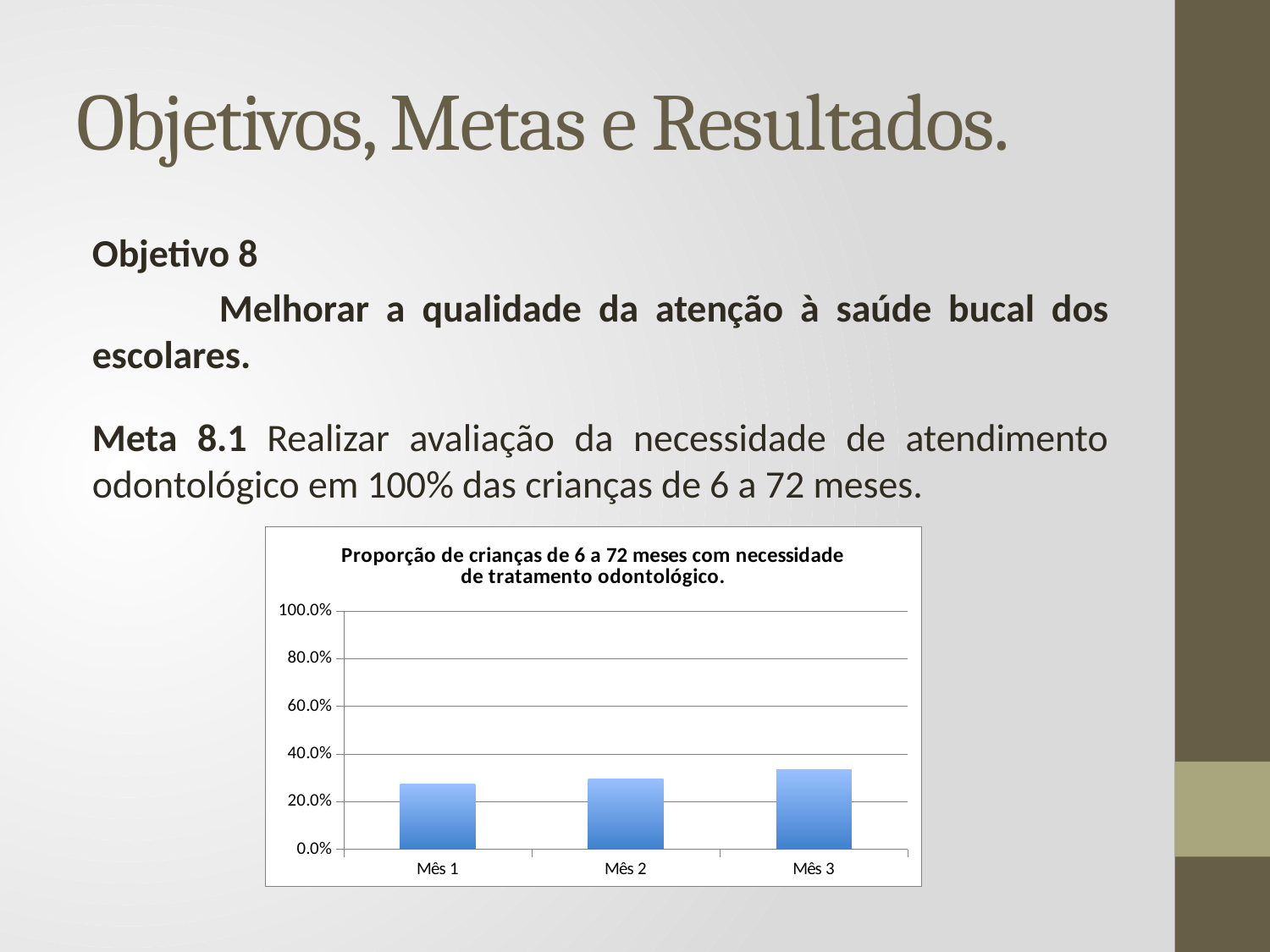
Is the value for Mês 1 greater or less than 20.0%? greater Is the value for Mês 1 greater or less than 40.0%? less What kind of chart is shown on the slide? bar chart Which is larger, the value for Mês 1 or the value for Mês 3? Mês 3 What is the title of the chart? Proporção de crianças de 6 a 72 meses com necessidade de tratamento odontológico. Is the value for Mês 3 greater or less than 40.0%? less How many categories (months) are plotted on the chart? 3 What is the highest value shown on the vertical axis of the chart? 100.0% Do the values rise or fall from Mês 1 to Mês 3? rise Which month has the highest value on the chart? Mês 3